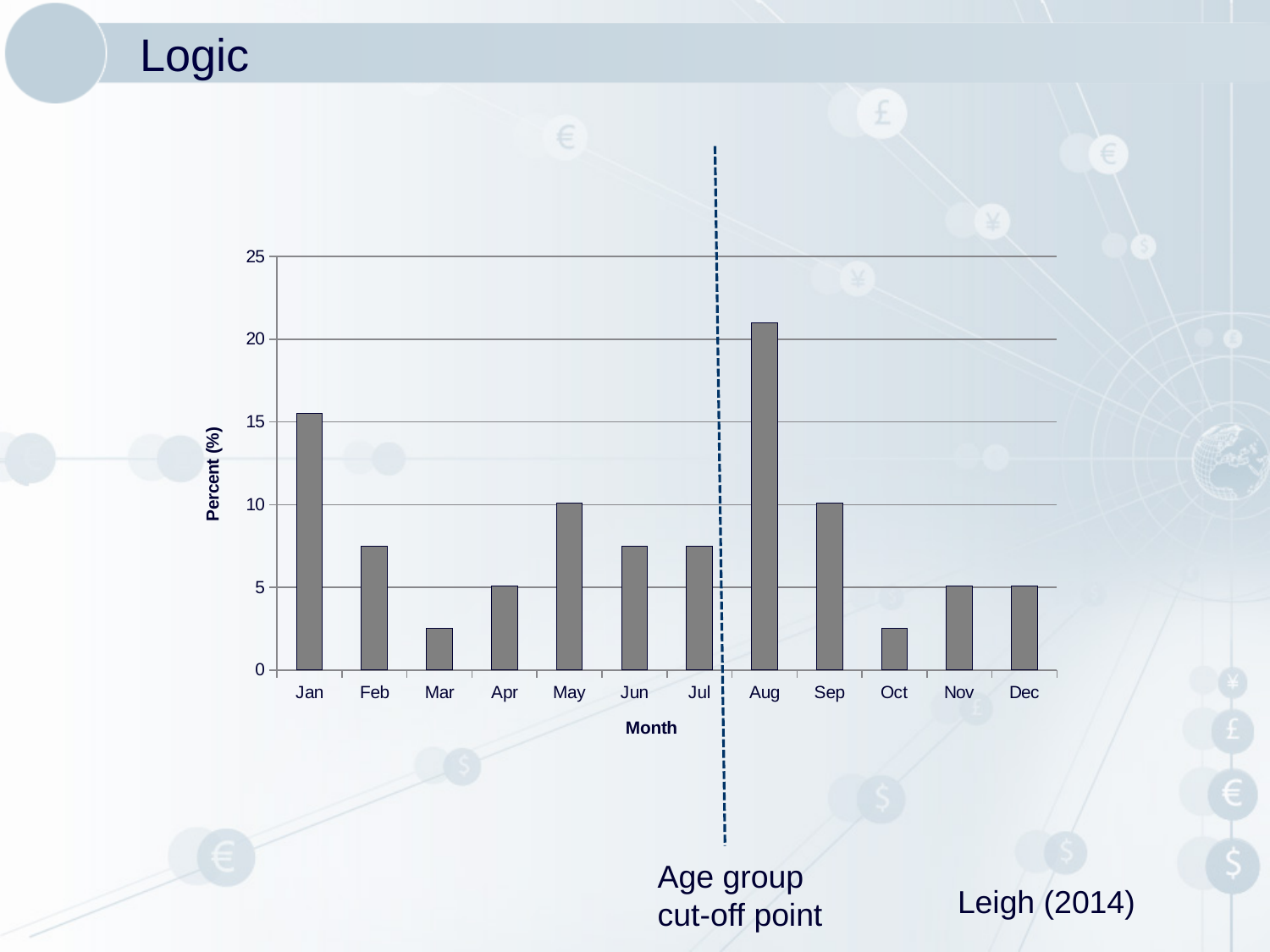
Which is larger, the value for Jan or the value for Feb? Jan Which month has the highest value in the chart? Aug Is the value for Mar greater or less than 5? less Is the value for Oct greater or less than 5? less Between which two months does the dashed 'Age group cut-off point' line fall? Jul and Aug Is the value for Aug greater or less than 20? greater What kind of chart is shown on the slide? bar chart How many months are shown on the x axis of the chart? 12 What is the label on the vertical axis of the chart? Percent (%) Which is larger, the value for Aug or the value for Sep? Aug